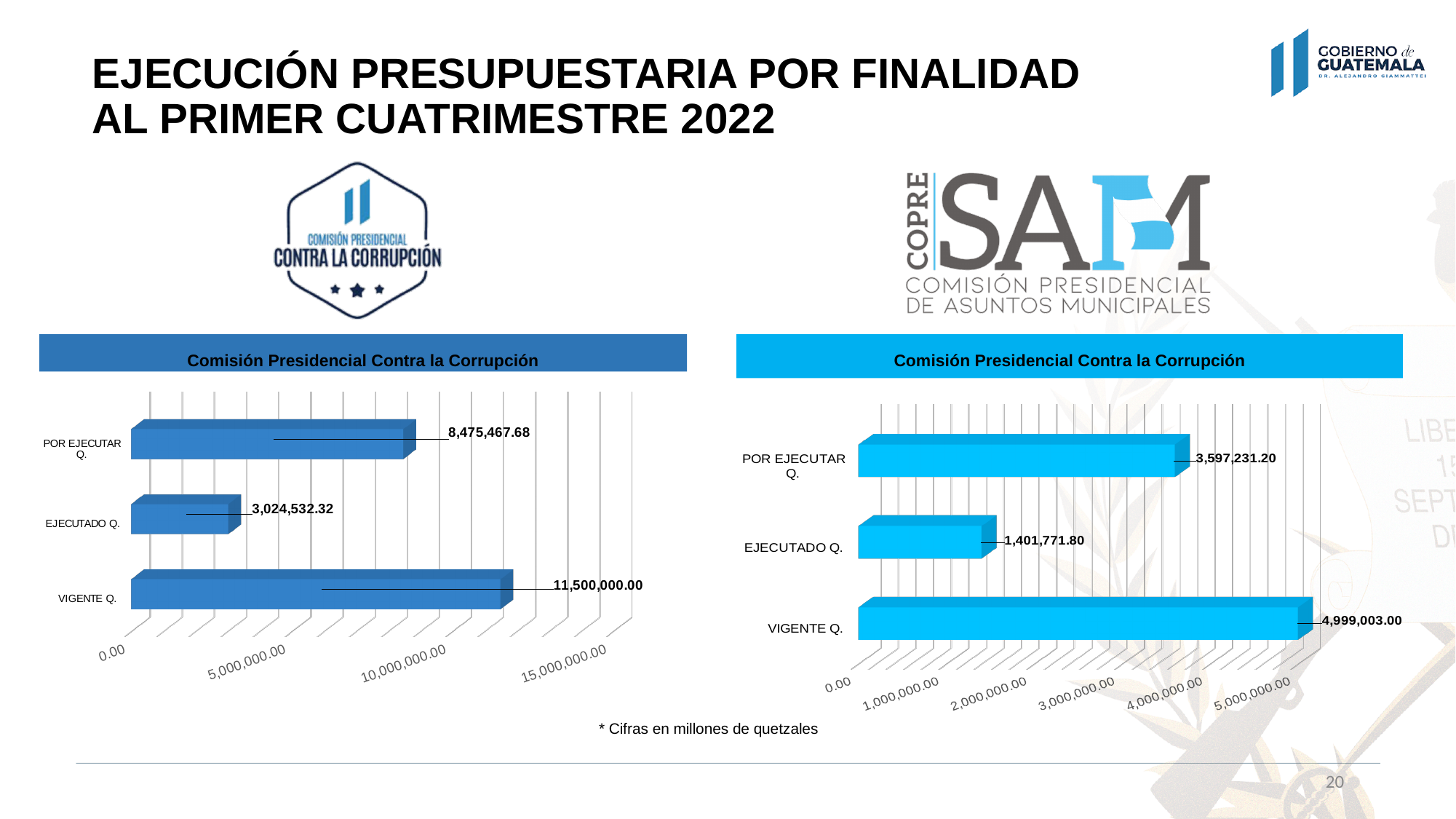
On the right chart, what is the difference between POR EJECUTAR Q. and EJECUTADO Q.? 2,195,459.40 On the right chart, what is the value for EJECUTADO Q.? 1,401,771.80 On the right chart, which is larger, VIGENTE Q. or POR EJECUTAR Q.? VIGENTE Q. How many categories does the right chart show? 3 What kind of chart is the left chart? bar chart On the left chart, which category has the highest value? VIGENTE Q. On the left chart, what is the value for EJECUTADO Q.? 3,024,532.32 On the left chart, what is the difference between VIGENTE Q. and EJECUTADO Q.? 8,475,467.68 On the left chart, what is the value for VIGENTE Q.? 11,500,000.00 On the right chart, which category has the lowest value? EJECUTADO Q. On the left chart, is the value for POR EJECUTAR Q. greater or less than 10,000,000.00? less On the right chart, what is the value for POR EJECUTAR Q.? 3,597,231.20